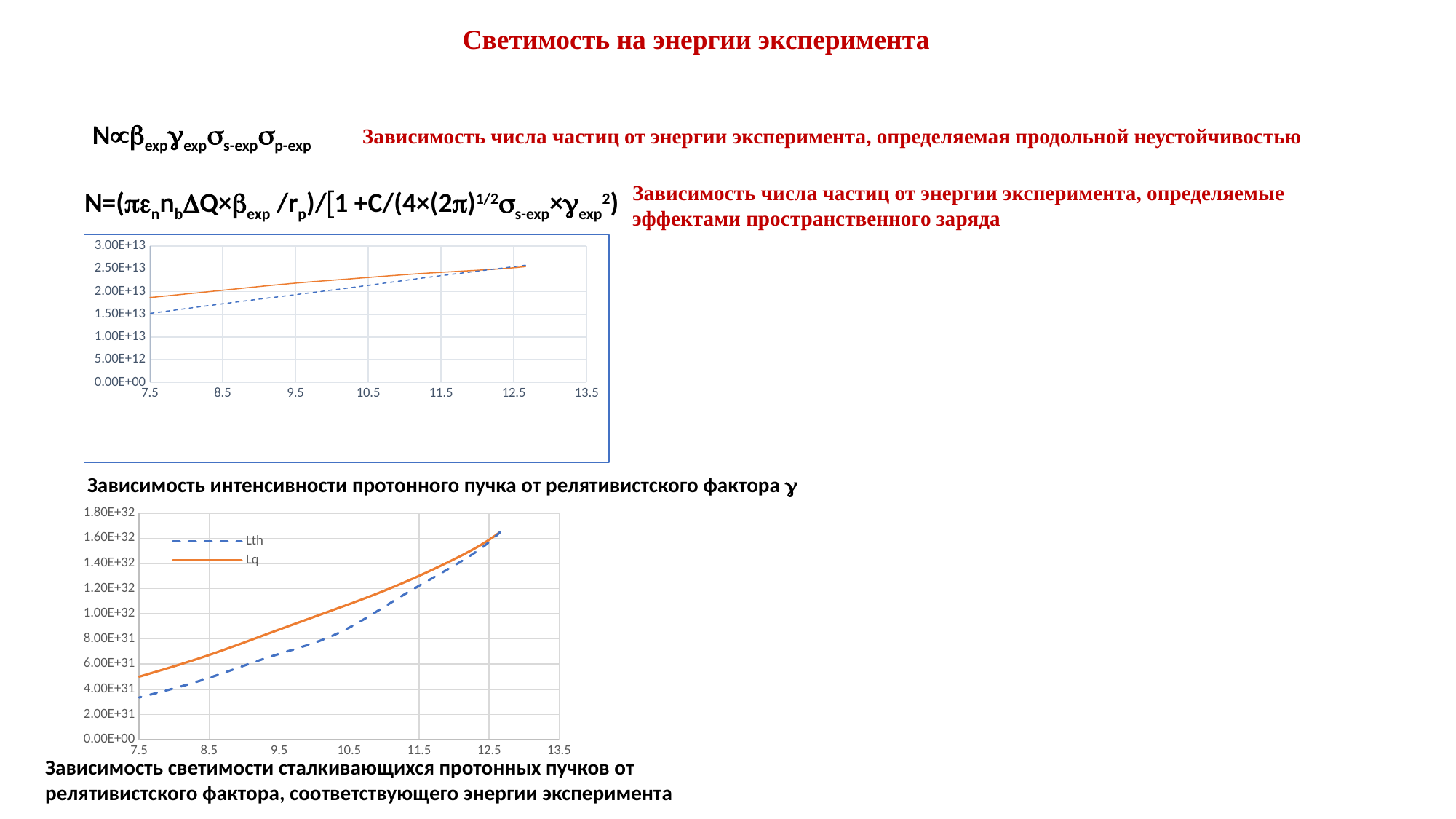
In the bottom chart, is the value of Lth at x = 7.5 greater or less than 4.00E+31? less In the top chart, at x = 7.5, which line has the larger value, the orange solid line or the blue dashed line? the orange solid line In the bottom chart, at x = 7.5, which series has the larger value, Lth or Lq? Lq In the bottom chart, do the Lq values rise or fall as the x axis increases from 7.5 to 12.5? rise What kind of chart is the bottom chart on the slide? line chart In the top chart, is the value of the blue dashed line at x = 7.5 greater or less than 2.00E+13? less In the bottom chart, is the value of Lth at x = 10.5 greater or less than 1.00E+32? less In the bottom chart, which series is drawn as a dashed line? Lth In the top chart, do the values of the orange solid line rise or fall as the x axis increases? rise What kind of chart is the top chart on the slide? line chart How many series does the legend of the bottom chart list? 2